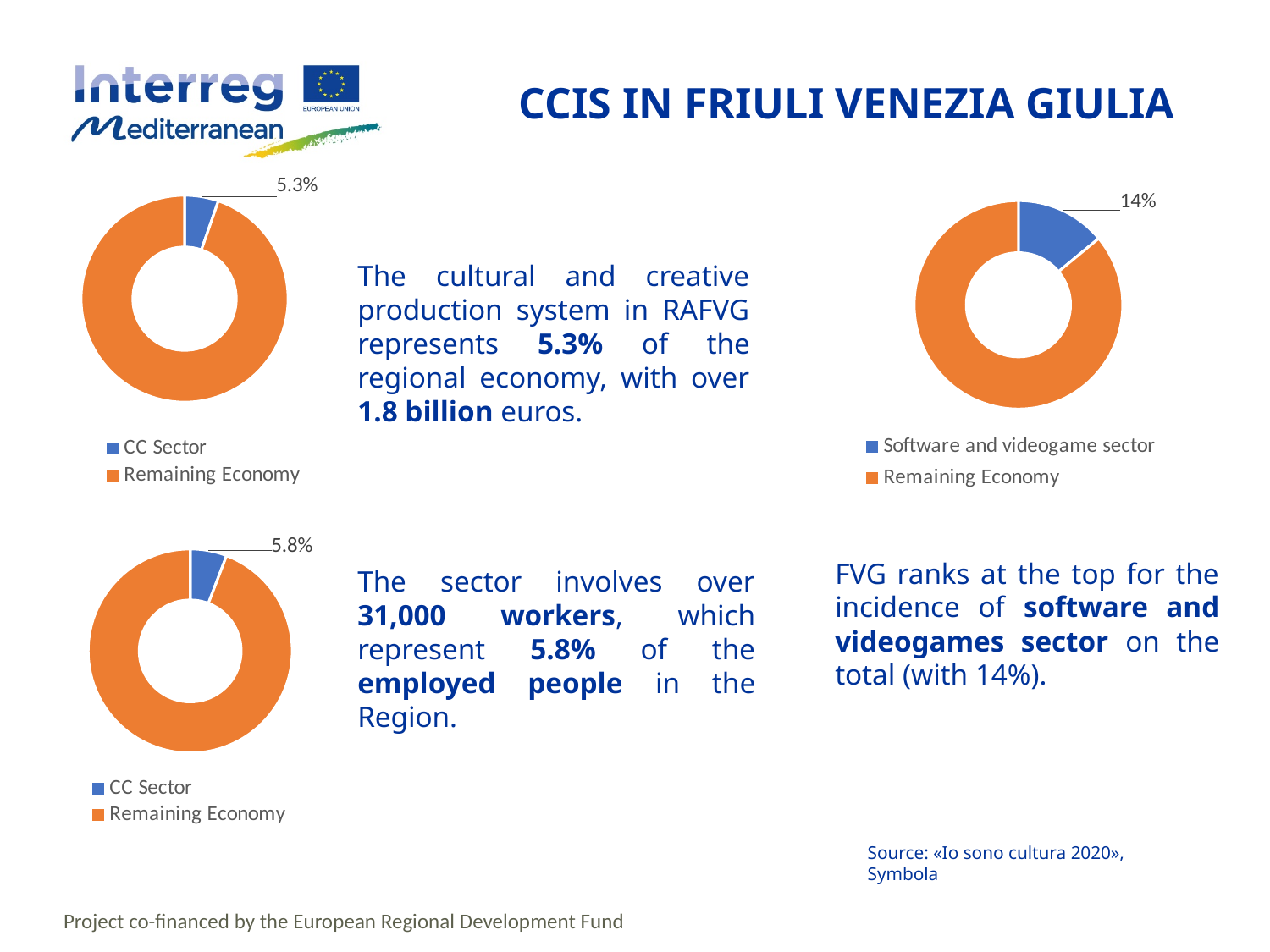
How many categories does the legend of the top-right chart list? 2 Which is larger: the CC Sector share in the top-left chart or the Software and videogame sector share in the top-right chart? Software and videogame sector share in the top-right chart What kind of chart is the top-left chart on the slide? Doughnut (pie) chart What are the two legend entries of the top-right chart? Software and videogame sector; Remaining Economy Is the Software and videogame sector share in the top-right chart greater or less than 10%? greater In the bottom-left chart, which category takes the smaller share of the ring? CC Sector What is the difference between the CC Sector share in the bottom-left chart (5.8%) and the CC Sector share in the top-left chart (5.3%)? 0.5% In the top-right chart, which category takes the larger share of the ring? Remaining Economy In the bottom-left doughnut chart, what percentage is shown for the CC Sector? 5.8% In the top-right doughnut chart, what percentage is shown for the Software and videogame sector? 14% What colour represents the Remaining Economy in the doughnut charts? Orange In the top-left doughnut chart, what percentage is shown for the CC Sector? 5.3%